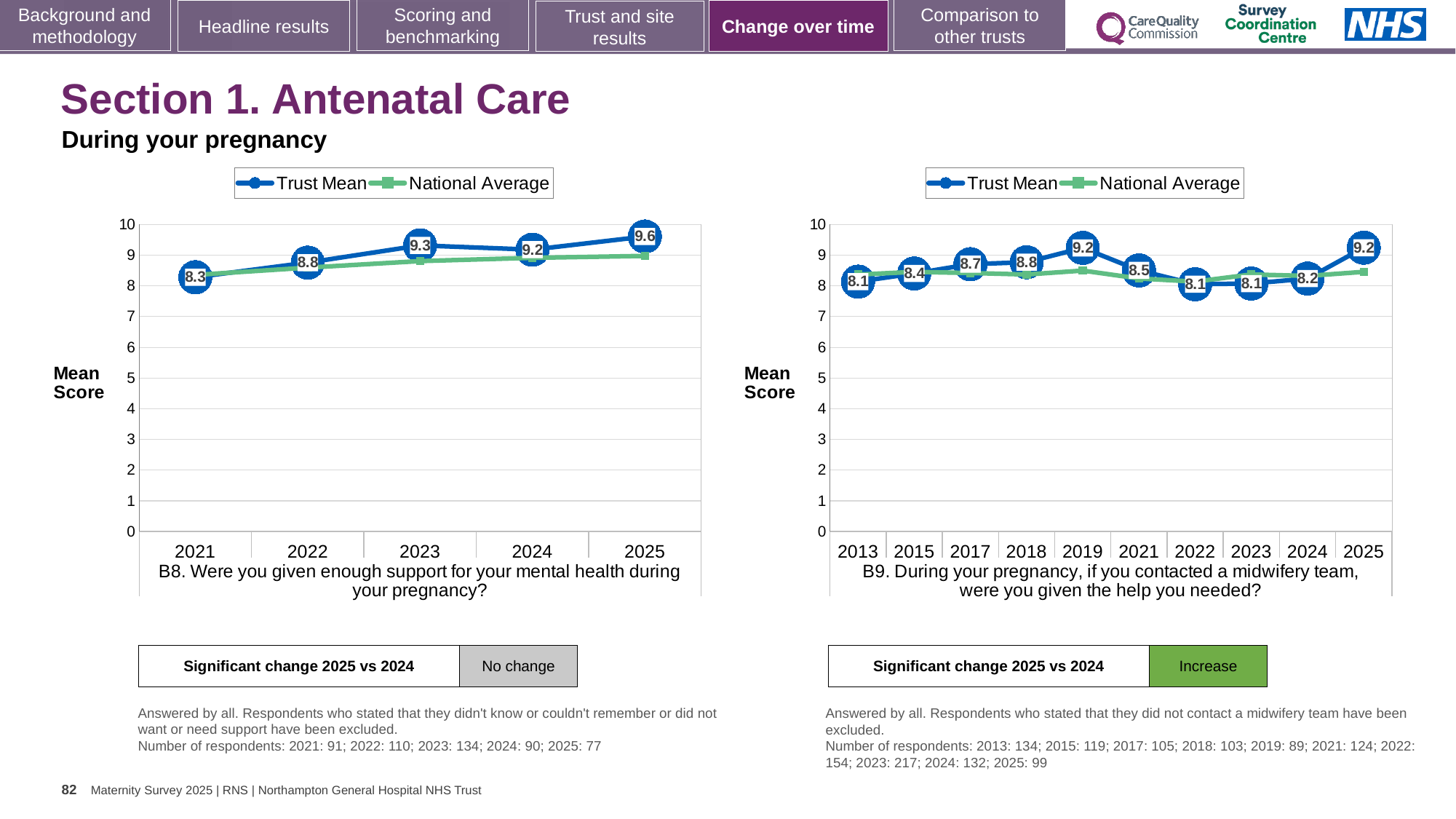
How many series does the legend of the B9 chart (right) list? 2 In the B8 chart (left), what is the difference between the Trust Mean in 2025 and in 2021? 1.3 In the B8 chart (left), what is the Trust Mean for 2021? 8.3 In the B9 chart (right), which year has the lowest Trust Mean? 2013, 2022 and 2023 (all 8.1) In the B9 chart (right), what is the Trust Mean for 2019? 9.2 In the B9 chart (right), how many years are shown on the x axis? 10 In the B8 chart (left), what is the Trust Mean for 2025? 9.6 In the B8 chart (left), which year has the highest Trust Mean? 2025 In the B9 chart (right), what is the Trust Mean for 2024? 8.2 In the B9 chart (right), is the Trust Mean for 2021 larger or smaller than the Trust Mean for 2018? smaller What kind of chart is the B8 chart (left)? Line chart In the B8 chart (left), how many years are shown on the x axis? 5